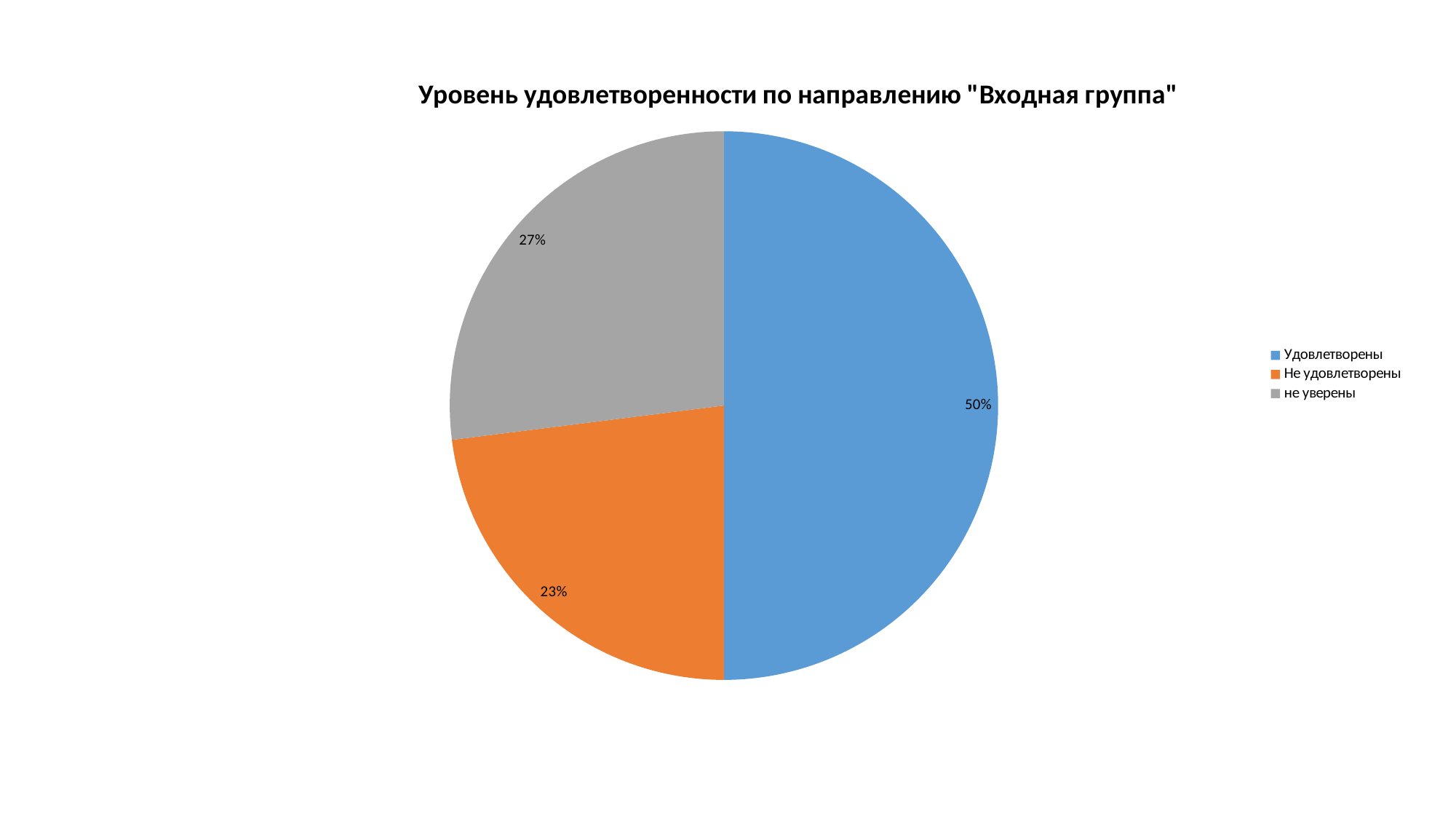
How many categories does the pie chart show? 3 Which colour represents "Не удовлетворены" in the legend? Orange What is the difference in percentage points between "не уверены" and "Не удовлетворены"? 4 Which category has the largest slice of the pie? Удовлетворены What share of the pie does "не уверены" represent? 27% What kind of chart is shown on the slide? Pie chart Which category has the smallest slice of the pie? Не удовлетворены What share of the pie does "Не удовлетворены" represent? 23% What share of the pie does "Удовлетворены" represent? 50% What is the difference in percentage points between "Удовлетворены" and "Не удовлетворены"? 27 Which is larger: the share for "не уверены" or the share for "Не удовлетворены"? не уверены What is the title of the chart? Уровень удовлетворенности по направлению "Входная группа"